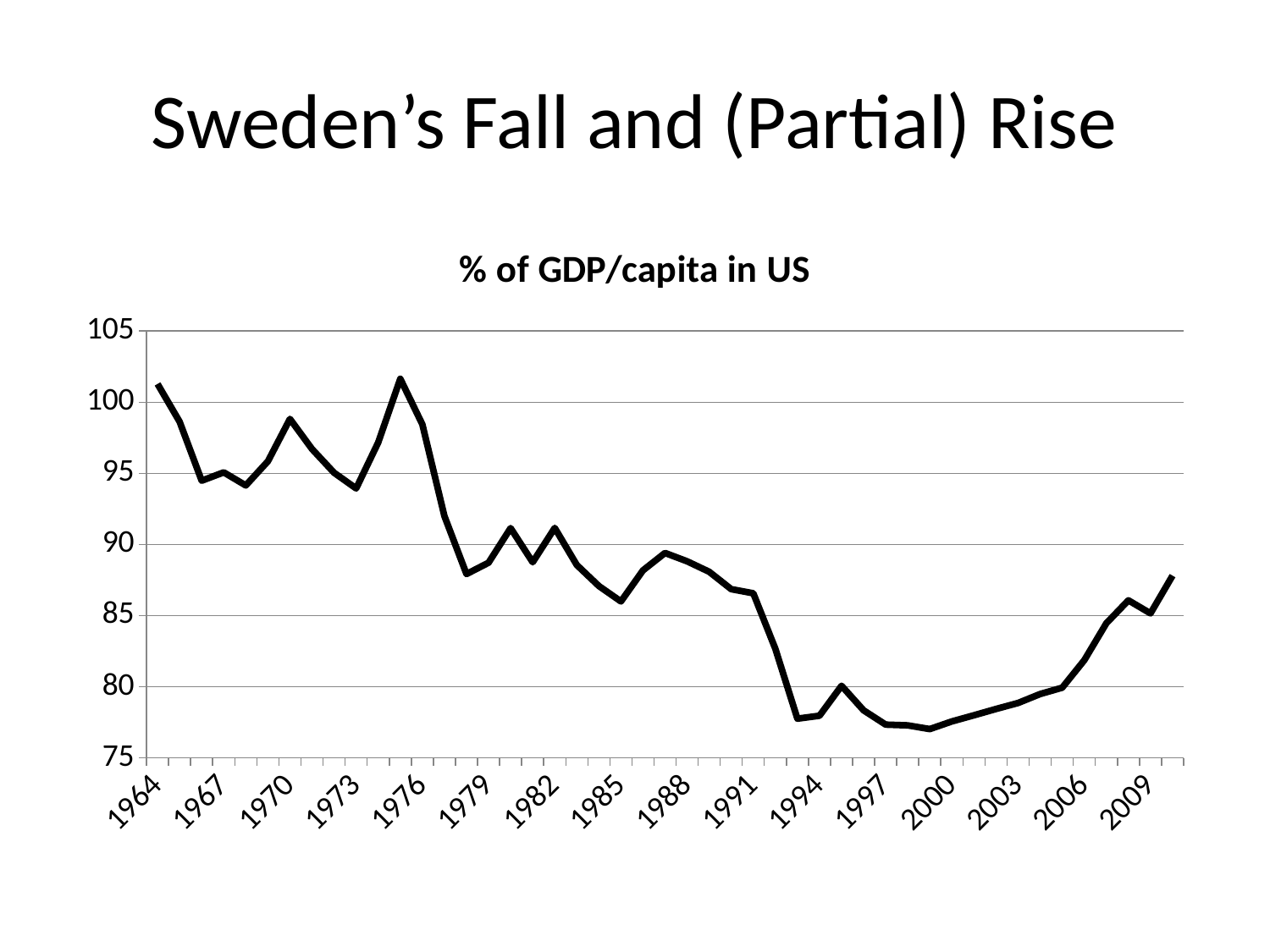
What is the title of the chart? % of GDP/capita in US Is the value for 1964 greater or less than 100? greater Is the value for 1985 greater or less than 90? less What kind of chart is shown on the slide? line chart Which is larger, the value for 1976 or the value for 1994? 1976 Which is larger, the value for 1988 or the value for 1997? 1988 Do the values generally rise or fall from 2000 to 2009? rise Is the value for 2000 greater or less than 80? less Do the values generally rise or fall from 1964 to 1994? fall